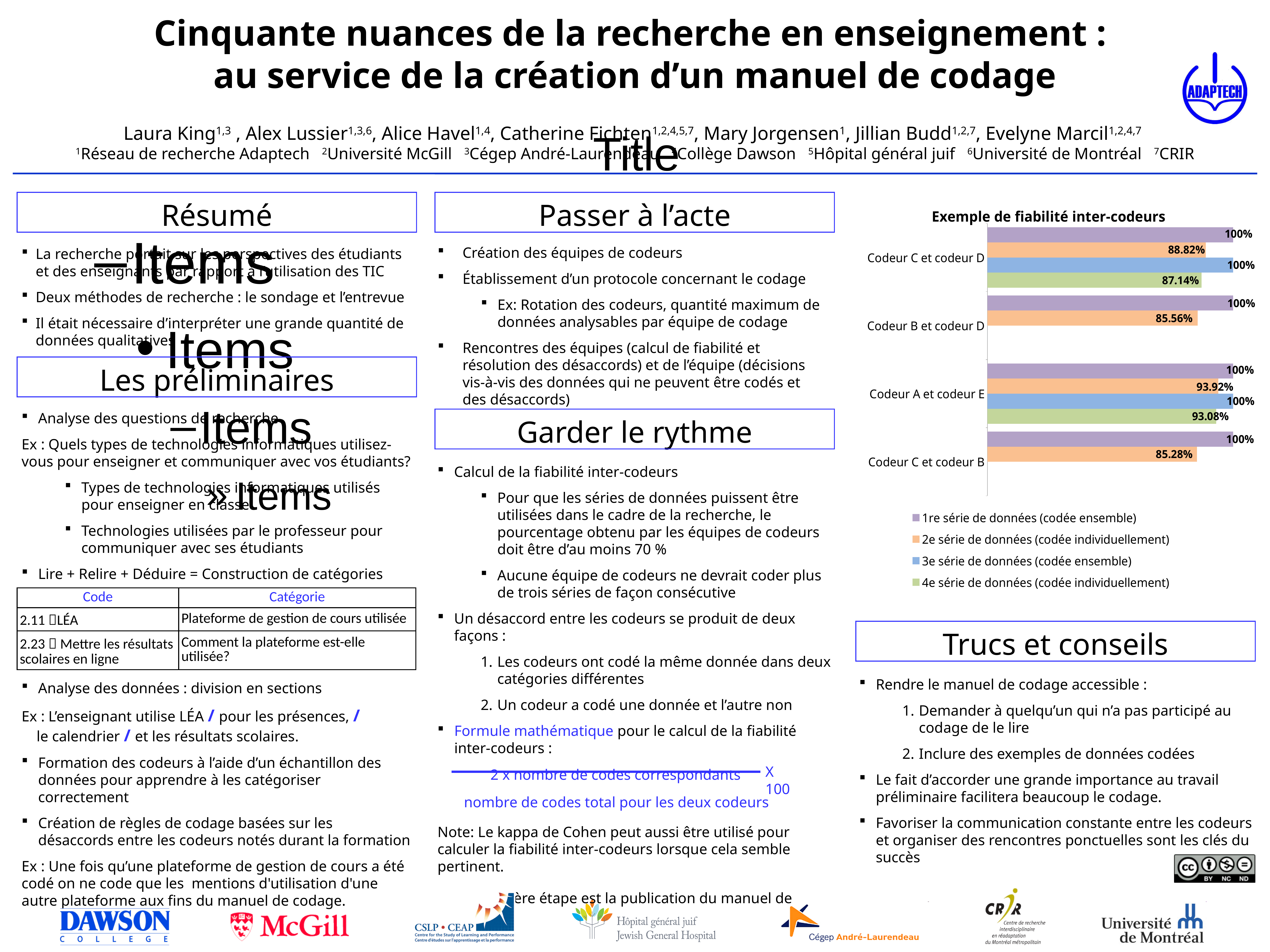
What is the value of the 2e série de données (codée individuellement) for Codeur B et codeur D? 85.56% What is the value of the 4e série de données (codée individuellement) for Codeur A et codeur E? 93.08% How many coder pairs (categories) are shown on the chart? 4 How many series does the chart legend list? 4 What is the difference between the 2e série and the 4e série values for Codeur C et codeur D? 1.68% Which coder pair has the highest value for the 2e série de données (codée individuellement)? Codeur A et codeur E What type of chart is shown on the slide? bar chart What is the value of the 2e série de données (codée individuellement) for Codeur C et codeur D? 88.82% What is the value of the 2e série de données (codée individuellement) for Codeur C et codeur B? 85.28% What is the title of the chart? Exemple de fiabilité inter-codeurs What is the value of the 1re série de données (codée ensemble) for Codeur A et codeur E? 100% Which is larger for Codeur A et codeur E: the 2e série de données or the 4e série de données? 2e série de données